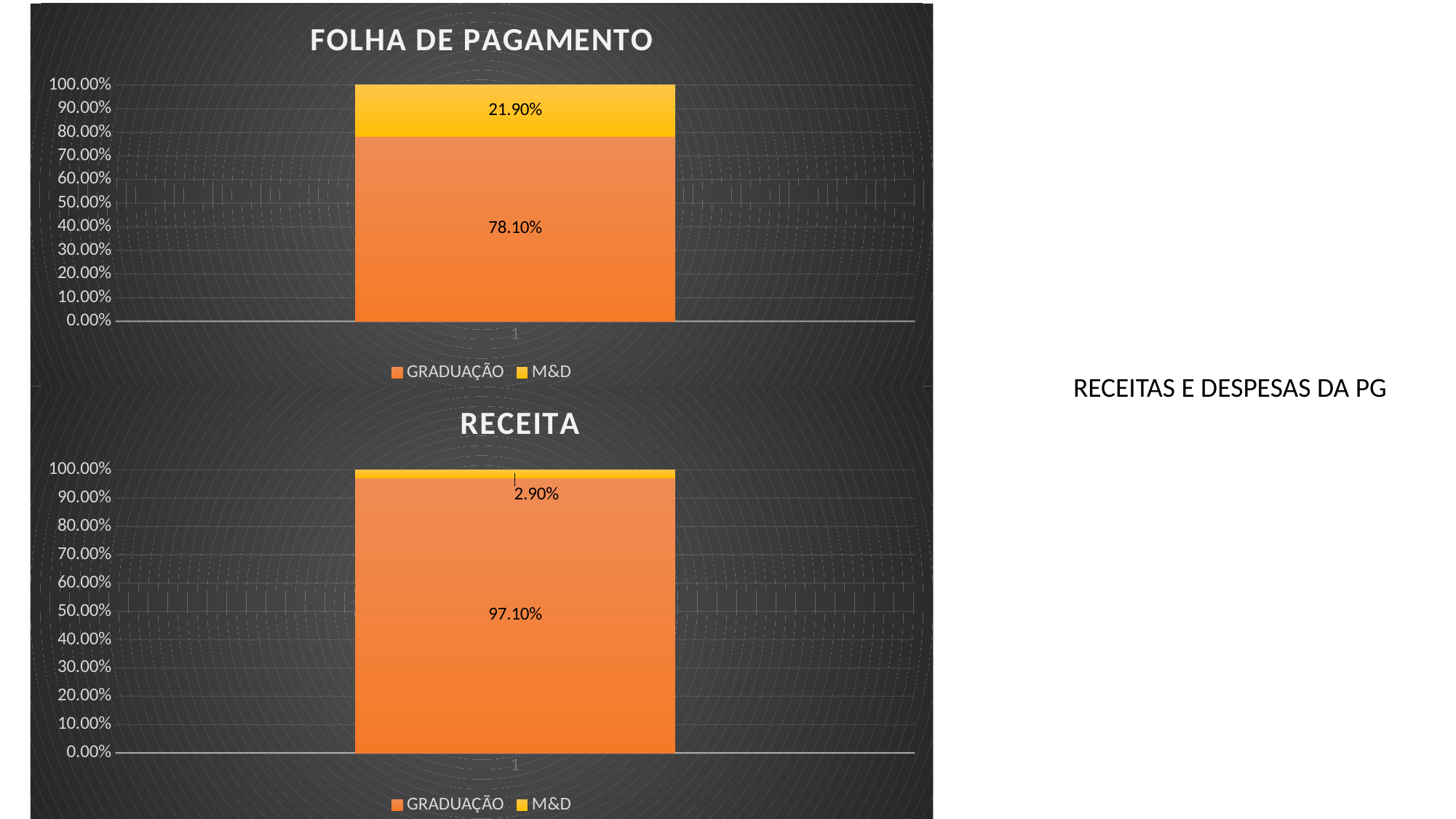
In the RECEITA chart, what is the difference between the GRADUAÇÃO and M&D values? 94.20% In the FOLHA DE PAGAMENTO chart, what is the difference between the GRADUAÇÃO and M&D values? 56.20% In the RECEITA chart, what is the total of the stacked bar? 100.00% In the FOLHA DE PAGAMENTO chart, what is the value for GRADUAÇÃO? 78.10% In the FOLHA DE PAGAMENTO chart, what is the value for M&D? 21.90% What is the title of the top chart on the slide? FOLHA DE PAGAMENTO In the FOLHA DE PAGAMENTO chart, which series has the larger value, GRADUAÇÃO or M&D? GRADUAÇÃO How many series does the legend of the FOLHA DE PAGAMENTO chart list? 2 In the RECEITA chart, which series has the smaller value? M&D What kind of chart is the RECEITA chart? Stacked bar chart In the RECEITA chart, what is the value for M&D? 2.90% In the RECEITA chart, what is the value for GRADUAÇÃO? 97.10%